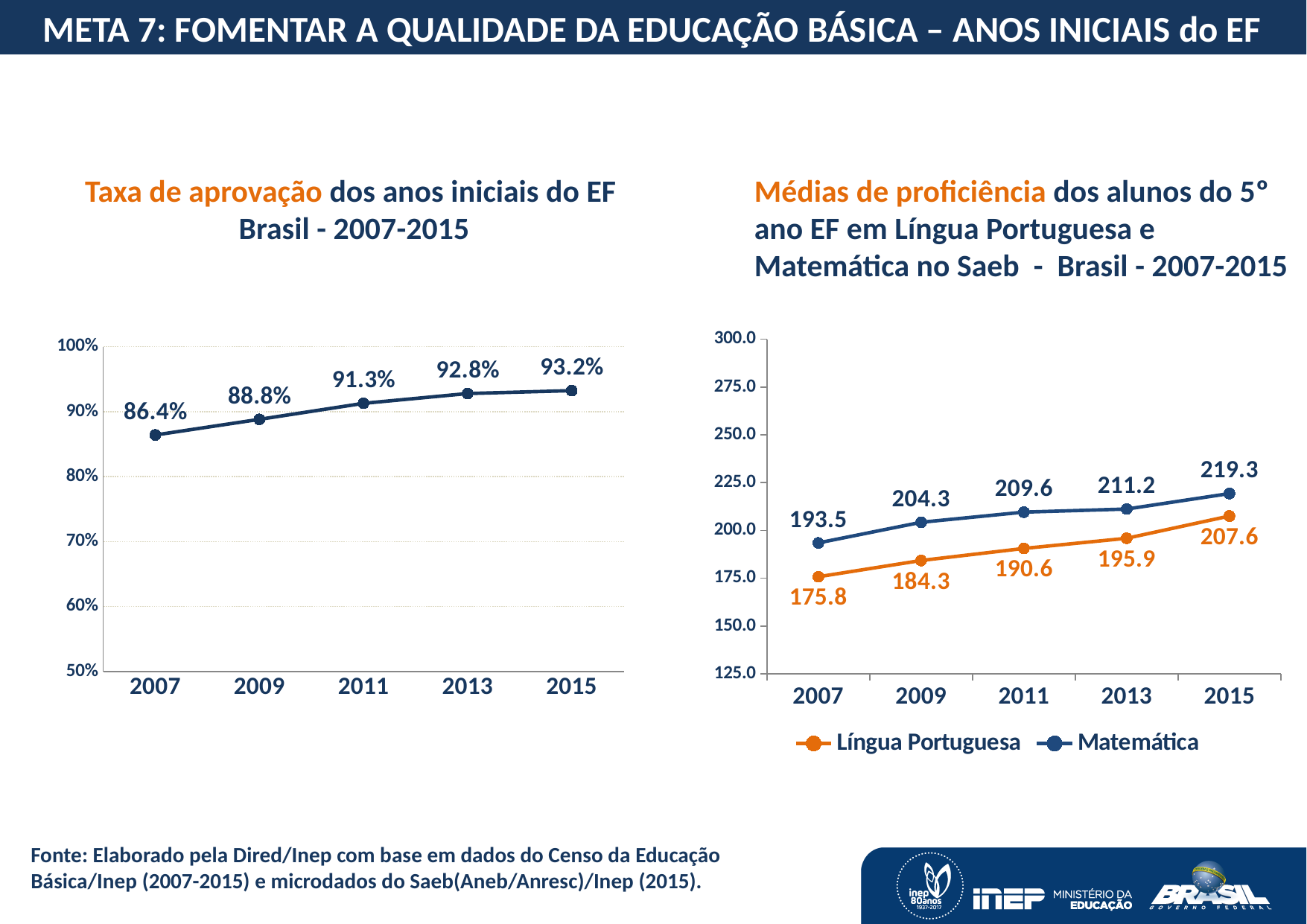
In the left chart (Taxa de aprovação dos anos iniciais do EF), how many years are plotted? 5 In the left chart (Taxa de aprovação dos anos iniciais do EF), what is the value for 2007? 86.4% In the right chart (Médias de proficiência), which series has the higher value in 2009, Língua Portuguesa or Matemática? Matemática In the left chart (Taxa de aprovação dos anos iniciais do EF), do the values rise or fall from 2007 to 2015? rise In the right chart (Médias de proficiência), what is the Língua Portuguesa value for 2007? 175.8 In the right chart (Médias de proficiência), how many series does the legend list? 2 In the right chart (Médias de proficiência), what is the difference between the Matemática and Língua Portuguesa values in 2015? 11.7 In the right chart (Médias de proficiência), which year has the highest Língua Portuguesa value? 2015 In the left chart (Taxa de aprovação dos anos iniciais do EF), what is the value for 2015? 93.2% What type of chart is the left chart (Taxa de aprovação dos anos iniciais do EF)? line chart In the left chart (Taxa de aprovação dos anos iniciais do EF), which year has the lowest approval rate? 2007 In the right chart (Médias de proficiência), what is the Matemática value for 2011? 209.6